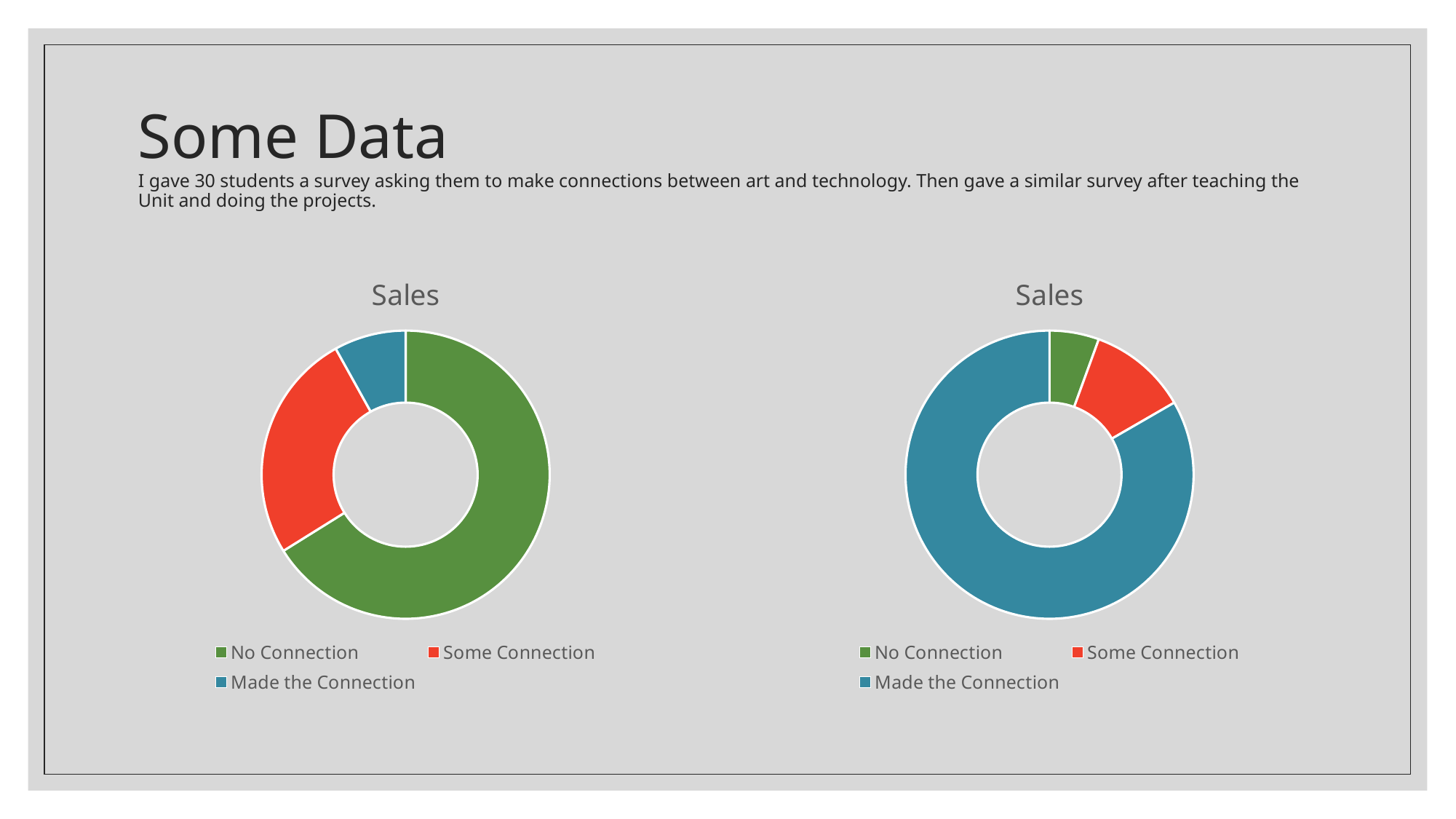
In the left chart, which slice is larger: Some Connection or Made the Connection? Some Connection How many categories does the right chart show? 3 In the right chart, what colour represents Made the Connection? Blue What kind of chart is the left chart on the slide? Doughnut chart In the left chart, which category has the largest slice? No Connection In the left chart, which category has the smallest slice? Made the Connection In the right chart, which category has the largest slice? Made the Connection In the right chart, which slice is larger: No Connection or Some Connection? Some Connection In the right chart, which category has the smallest slice? No Connection What kind of chart is the right chart on the slide? Doughnut chart What is the title of the left chart? Sales How many categories does the left chart show? 3